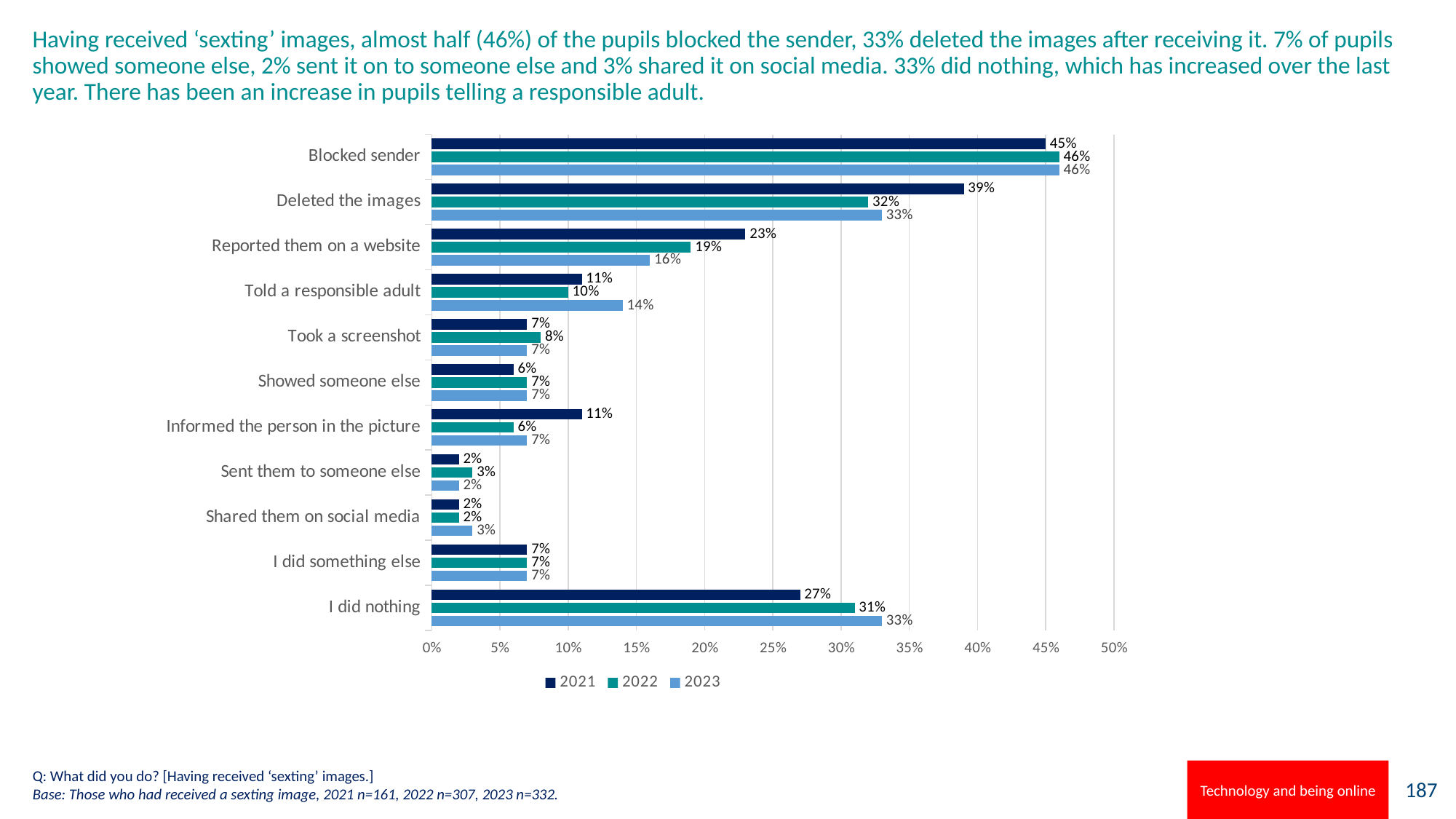
What is the difference between the 2023 and 2021 values for 'I did nothing'? 6 percentage points How many series does the legend list? 3 Which is larger: the 2021 value for 'Reported them on a website' or the 2023 value for 'Reported them on a website'? 2021 What percentage of pupils told a responsible adult in 2023? 14% Which category has the highest value for 2022? Blocked sender Which years are listed in the chart legend? 2021, 2022, 2023 How many categories are shown on the chart? 11 What was the value for 'Deleted the images' in 2021? 39% What percentage of pupils blocked the sender in 2023? 46% What kind of chart is shown on the slide? Bar chart Which category has the lowest value for 2023? Sent them to someone else Is the 2021 value for 'Blocked sender' greater or less than 40%? greater